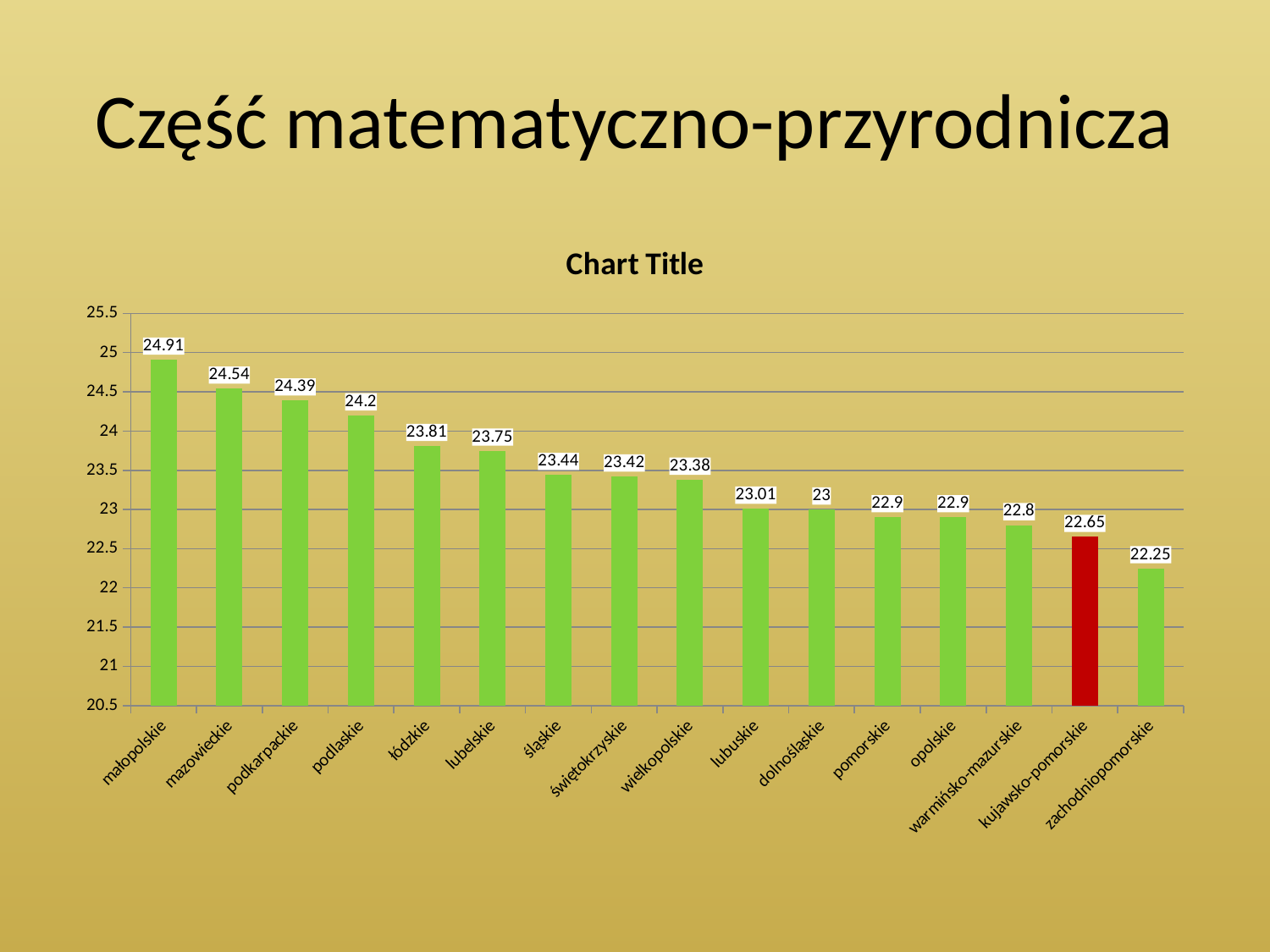
What is the value for lubuskie? 23.01 What is the difference between the values for małopolskie and zachodniopomorskie? 2.66 What is the difference between the values for mazowieckie and podkarpackie? 0.15 Which category has the highest value? małopolskie What kind of chart is shown on the slide? bar chart How many categories are shown on the x axis? 16 Which bar is coloured red instead of green? kujawsko-pomorskie Which is larger, the value for łódzkie or the value for lubelskie? łódzkie Is the value for podlaskie greater or less than 24? greater What is the value for małopolskie? 24.91 Which category has the lowest value? zachodniopomorskie What is the value for kujawsko-pomorskie? 22.65